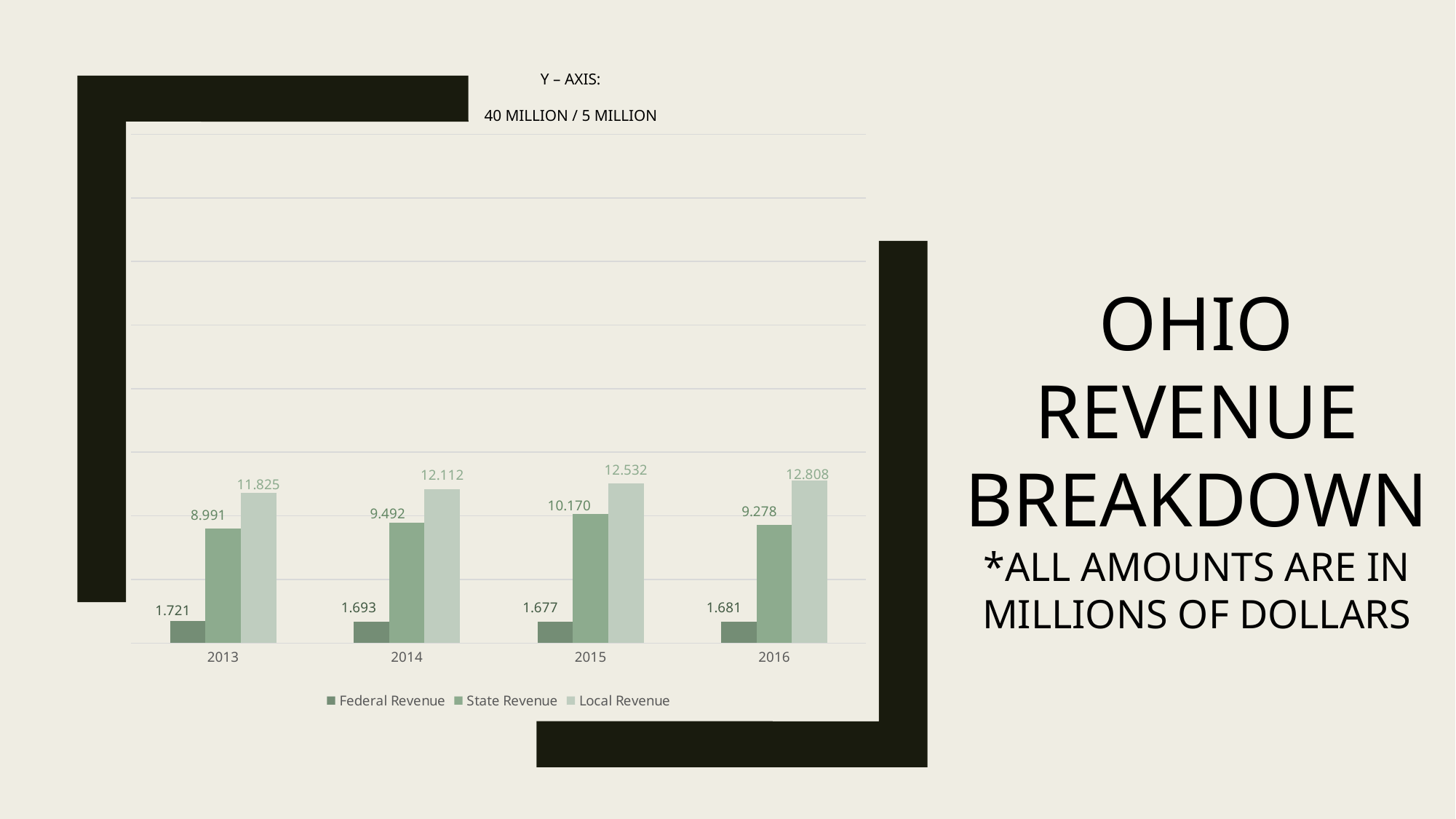
What kind of chart is shown on the slide? Bar chart How many years are shown on the x axis? 4 How many series does the legend list? 3 What is the Federal Revenue value for 2013? 1.721 What is the State Revenue value for 2014? 9.492 In which year is State Revenue highest? 2015 Does Local Revenue rise or fall from 2013 to 2016? Rise In which year is Federal Revenue lowest? 2015 Which is larger in 2013: State Revenue or Local Revenue? Local Revenue What is the Local Revenue value for 2015? 12.532 In which year is Local Revenue highest? 2016 What is the difference between Local Revenue and State Revenue in 2016? 3.530